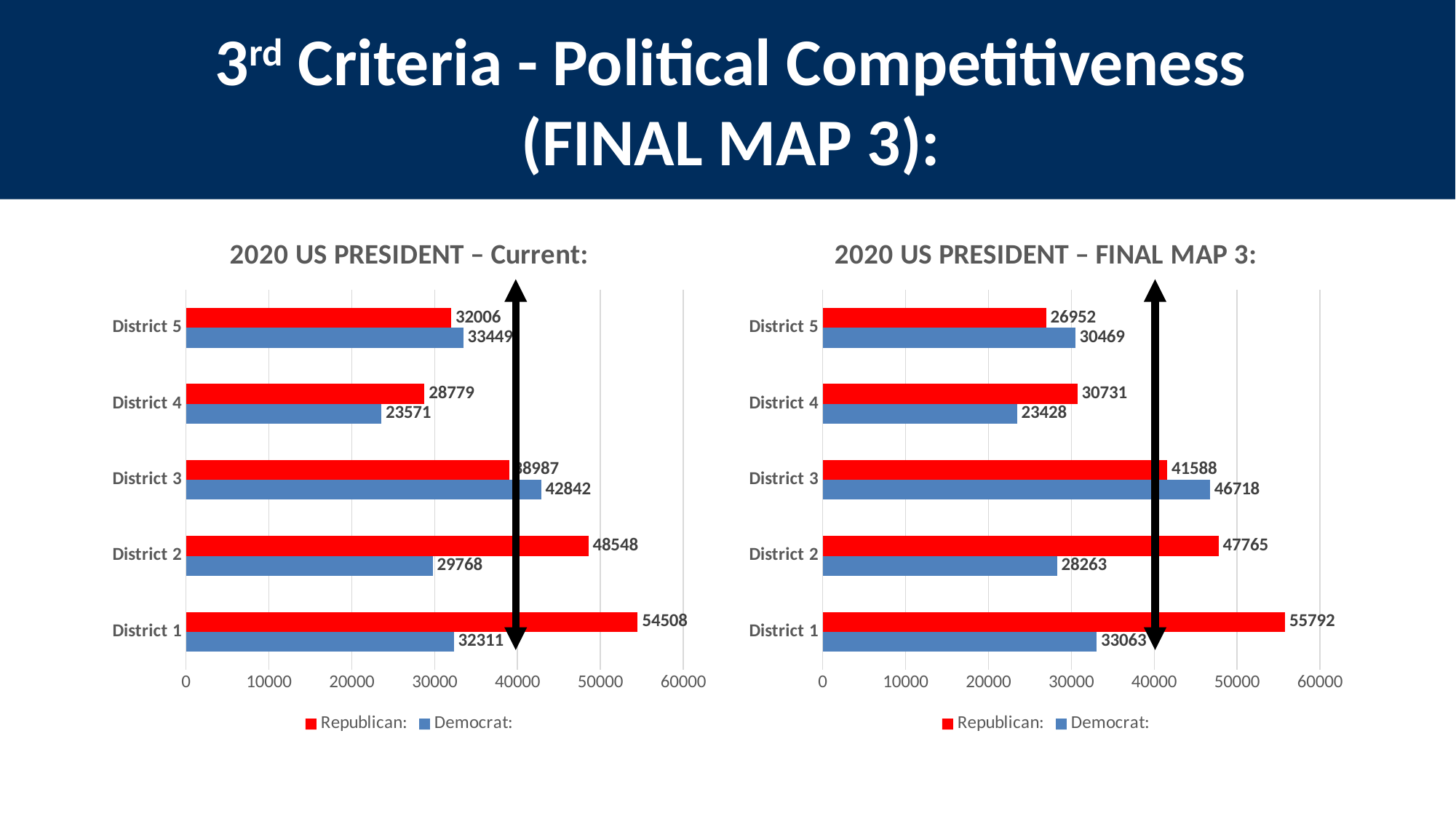
How many districts are shown in the "2020 US PRESIDENT – Current:" chart? 5 In the "2020 US PRESIDENT – FINAL MAP 3:" chart, what is the difference between the Democrat and Republican values for District 5? 3517 In the "2020 US PRESIDENT – FINAL MAP 3:" chart, which district has the highest Republican value? District 1 What type of chart is the "2020 US PRESIDENT – Current:" chart? Bar chart In the "2020 US PRESIDENT – FINAL MAP 3:" chart, what is the Democrat value for District 3? 46718 How many series does the legend of the "2020 US PRESIDENT – FINAL MAP 3:" chart list? 2 In the "2020 US PRESIDENT – Current:" chart, what is the Republican value for District 1? 54508 In the "2020 US PRESIDENT – FINAL MAP 3:" chart, which district has the lowest Democrat value? District 4 In the "2020 US PRESIDENT – FINAL MAP 3:" chart, is the Republican value for District 2 greater or less than 40000? greater In the "2020 US PRESIDENT – Current:" chart, what is the difference between the Republican and Democrat values for District 2? 18780 In the "2020 US PRESIDENT – Current:" chart, which is larger for District 3, the Republican value or the Democrat value? Democrat In the "2020 US PRESIDENT – Current:" chart, what is the Democrat value for District 4? 23571